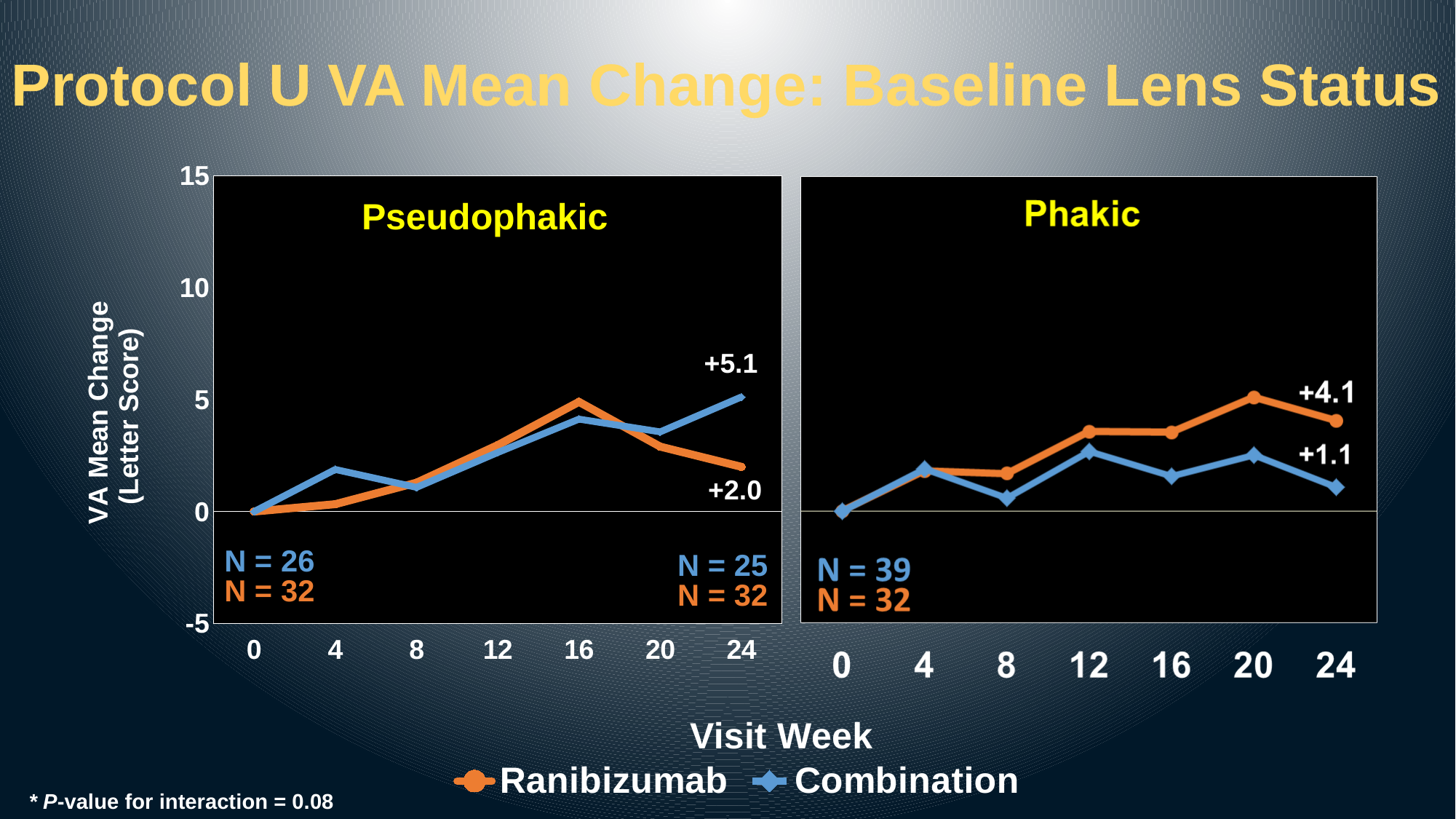
In the Phakic chart, which series has the higher value at week 24, Ranibizumab or Combination? Ranibizumab How many series does the legend list? 2 How many visit weeks are shown on the x axis of the Phakic chart? 7 In the Phakic chart, what is the VA mean change for Combination at week 24? +1.1 In the Pseudophakic chart, what is the VA mean change for Combination at week 24? +5.1 In the Pseudophakic chart, what is the difference between the Combination and Ranibizumab values at week 24? 3.1 In the Phakic chart, what is the difference between the Ranibizumab and Combination values at week 24? 3.0 In the Pseudophakic chart, what is the VA mean change for Ranibizumab at week 24? +2.0 In the Phakic chart, what is the VA mean change for Ranibizumab at week 24? +4.1 In the Phakic chart, is the Ranibizumab value at week 20 greater or less than 0? greater In the Pseudophakic chart, which series has the higher value at week 24, Ranibizumab or Combination? Combination What kind of chart is the Pseudophakic chart? line chart